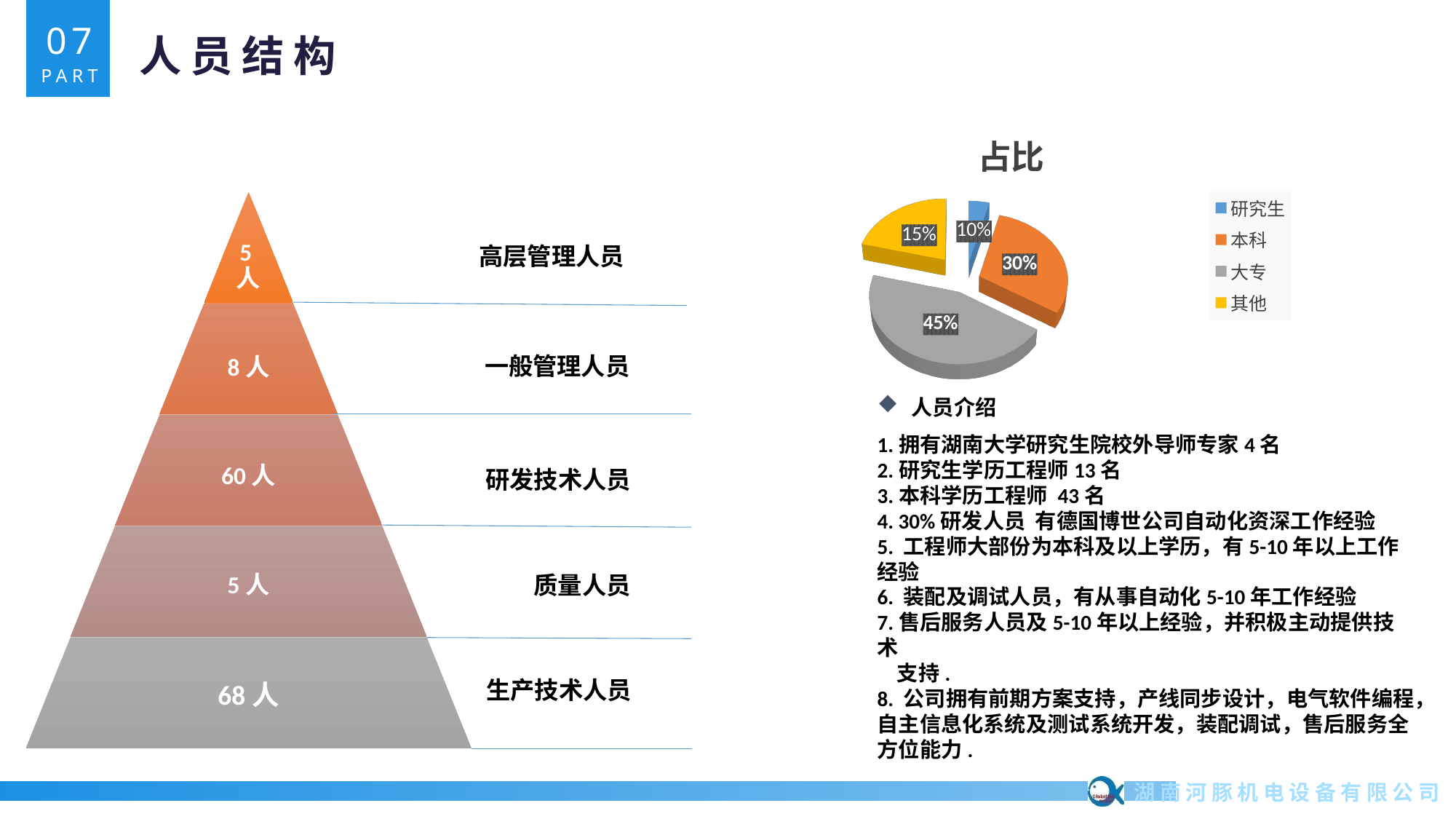
In the pie chart titled 占比, what share is labelled for 其他? 15% In the pie chart titled 占比, what share is labelled for 本科? 30% In the pie chart titled 占比, which category has the largest share? 大专 In the pie chart titled 占比, what colour is the slice for 其他? yellow In the pie chart titled 占比, what share is labelled for 研究生? 10% What is the title of the pie chart on the right of the slide? 占比 How many categories does the legend of the pie chart titled 占比 list? 4 What kind of chart is the chart titled 占比? pie chart In the pie chart titled 占比, which is larger, the share for 其他 or the share for 研究生? 其他 In the pie chart titled 占比, what is the difference in percentage points between 大专 and 本科? 15 In the pie chart titled 占比, which category has the smallest share? 研究生 In the pie chart titled 占比, what share is labelled for 大专? 45%